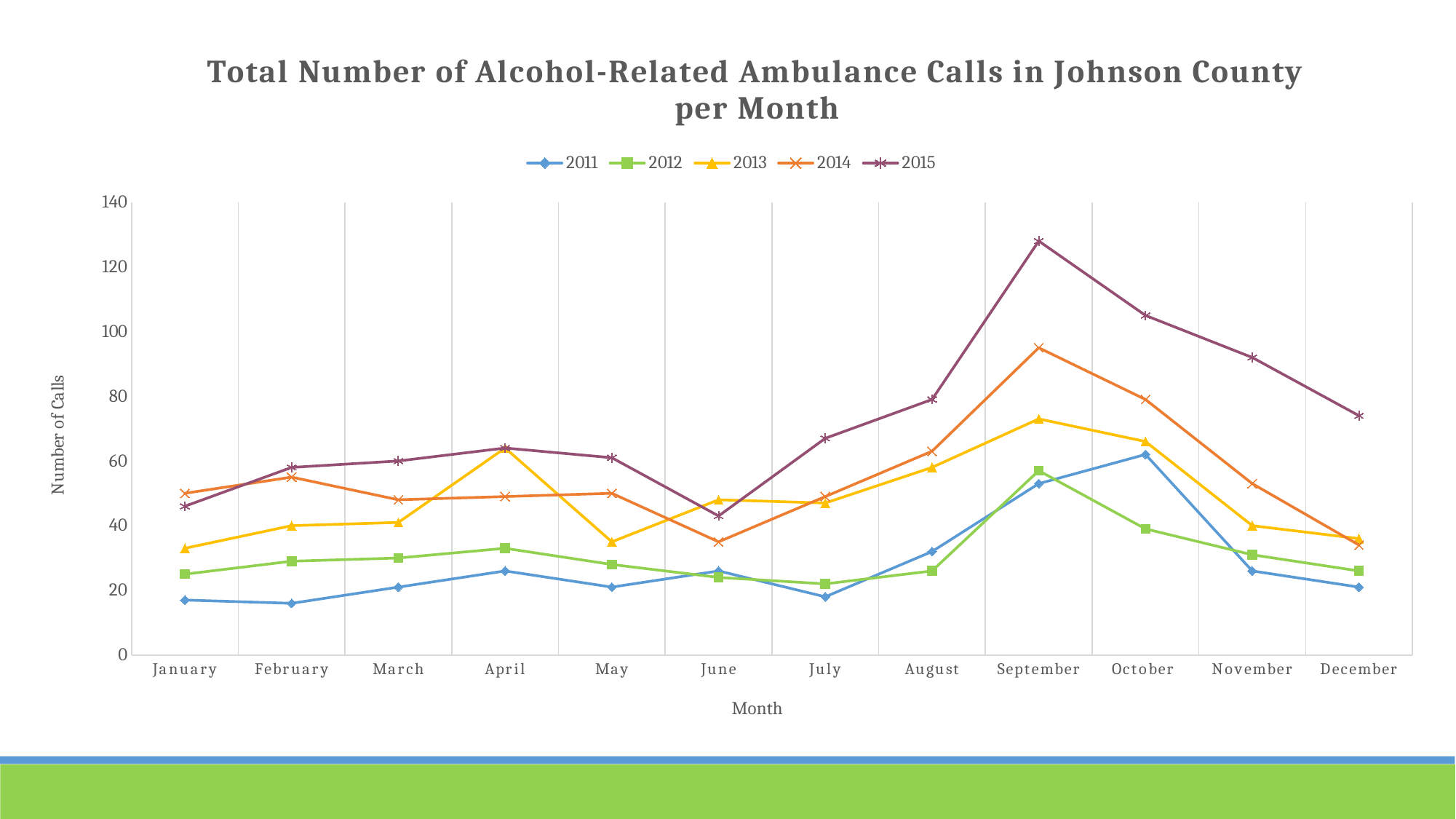
Is the value for 2015 in September greater or less than 120? greater Is the value for 2014 in September greater or less than 100? less How many months are plotted along the x axis? 12 What kind of chart is shown on the slide? Line chart In which month does the 2013 series reach its highest value? September Which series has the larger value in October, 2011 or 2012? 2011 How many series does the legend list? 5 Does the 2015 series rise or fall from September to December? Fall In which month does the 2015 series reach its highest value? September What is the label on the vertical axis? Number of Calls Is the value for 2011 in January greater or less than 20? less In which month does the 2011 series reach its highest value? October